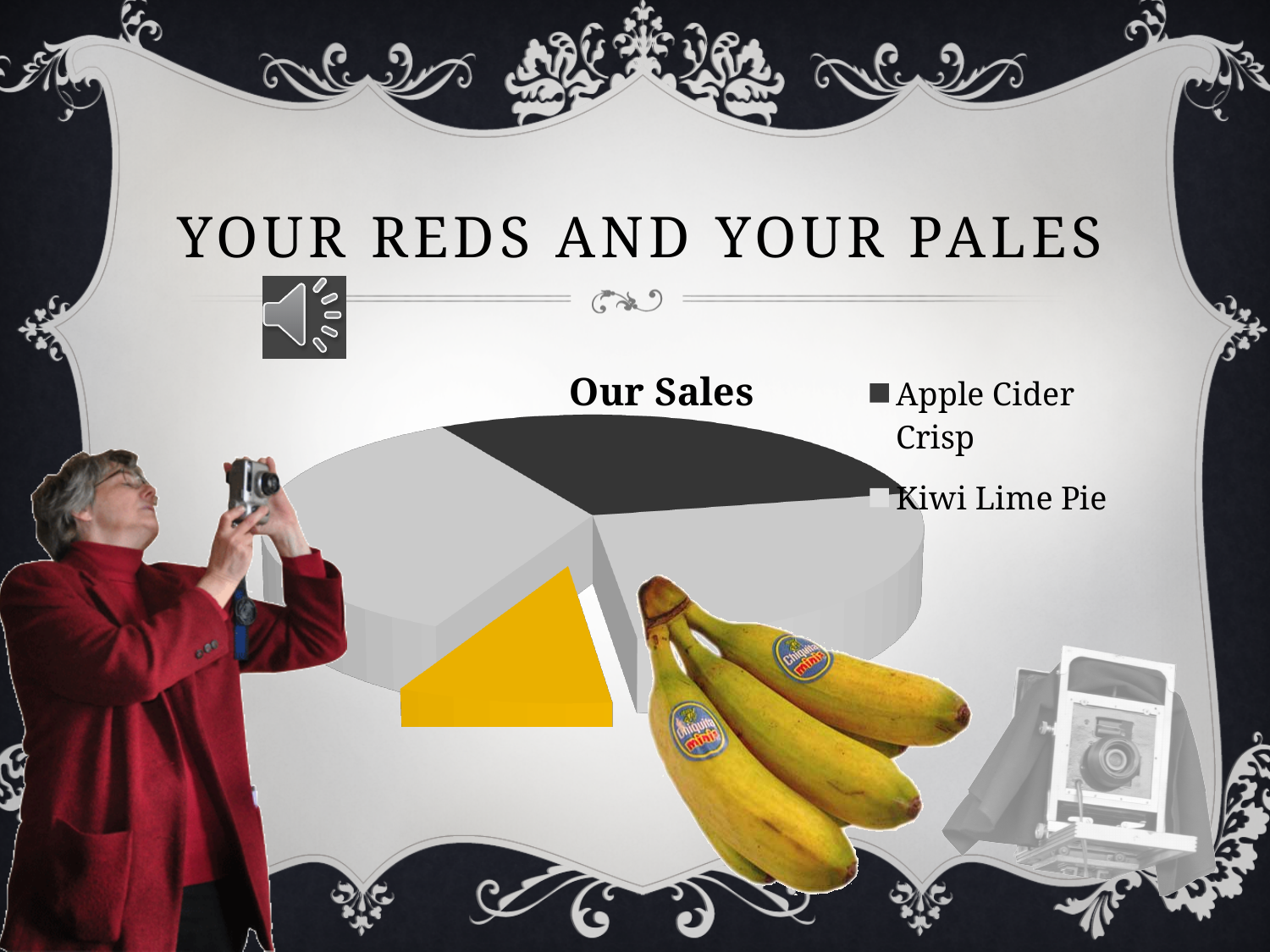
Which category is shown in light grey in the Our Sales pie chart? Kiwi Lime Pie What is the title of the chart? Our Sales What kind of chart is shown on the slide? pie chart How many slices does the Our Sales pie chart have? 4 Which slice is larger in the Our Sales pie chart, Apple Cider Crisp or Kiwi Lime Pie? Apple Cider Crisp